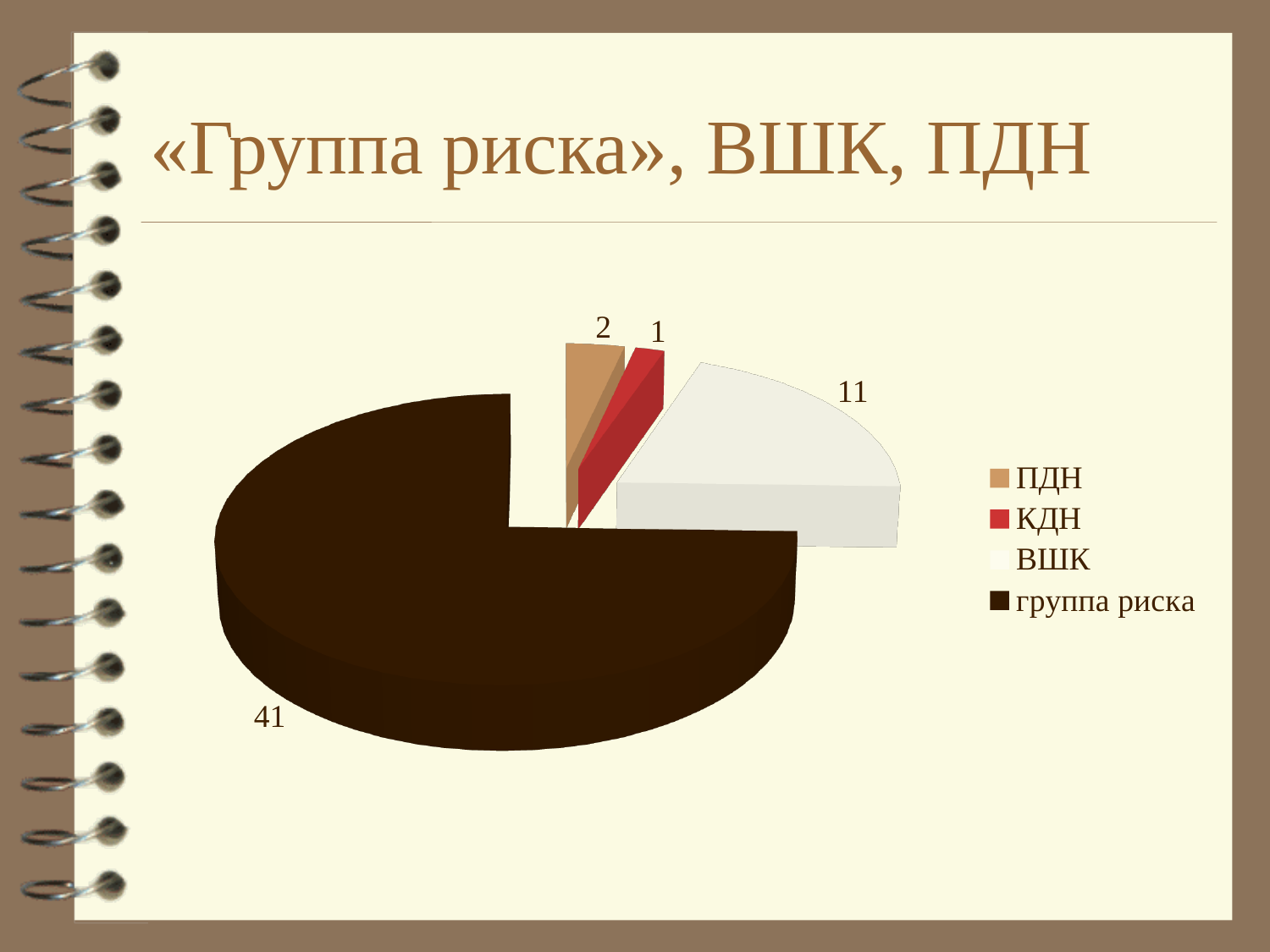
What is the difference between the values for группа риска and ВШК? 30 How many slices does the pie chart have? 4 What share of the pie does the ВШК slice represent? 20% Which category has the smallest slice? КДН What kind of chart is shown on the slide? pie chart What is the value for КДН? 1 What is the total of all the slices in the pie chart? 55 What is the value for группа риска? 41 What is the value for ВШК? 11 What is the value for ПДН? 2 Which is larger, the value for ПДН or the value for КДН? ПДН Which category has the largest slice? группа риска